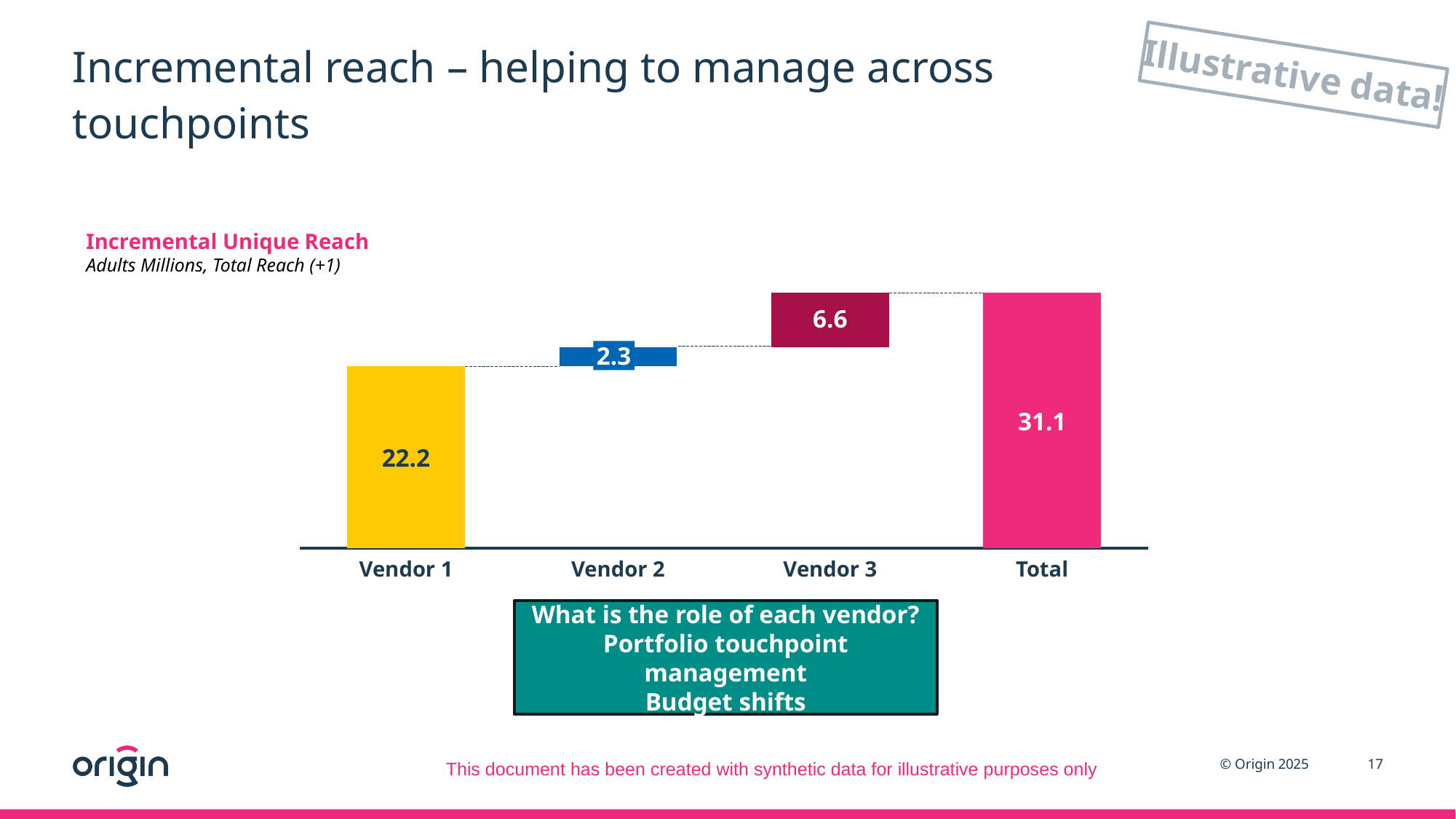
How many categories are shown on the x axis of the chart? 4 What kind of chart is shown on the slide? Bar chart (waterfall) What is the difference between the values for Vendor 1 and Vendor 3? 15.6 What is the title of the chart? Incremental Unique Reach Which vendor contributes the largest incremental unique reach? Vendor 1 What is the incremental unique reach value for Vendor 1? 22.2 What is the difference between the values for Vendor 3 and Vendor 2? 4.3 What is the incremental unique reach value for Vendor 3? 6.6 What is the value shown for the Total bar? 31.1 What is the incremental unique reach value for Vendor 2? 2.3 Which has a larger value, Vendor 2 or Vendor 3? Vendor 3 Which vendor contributes the smallest incremental unique reach? Vendor 2